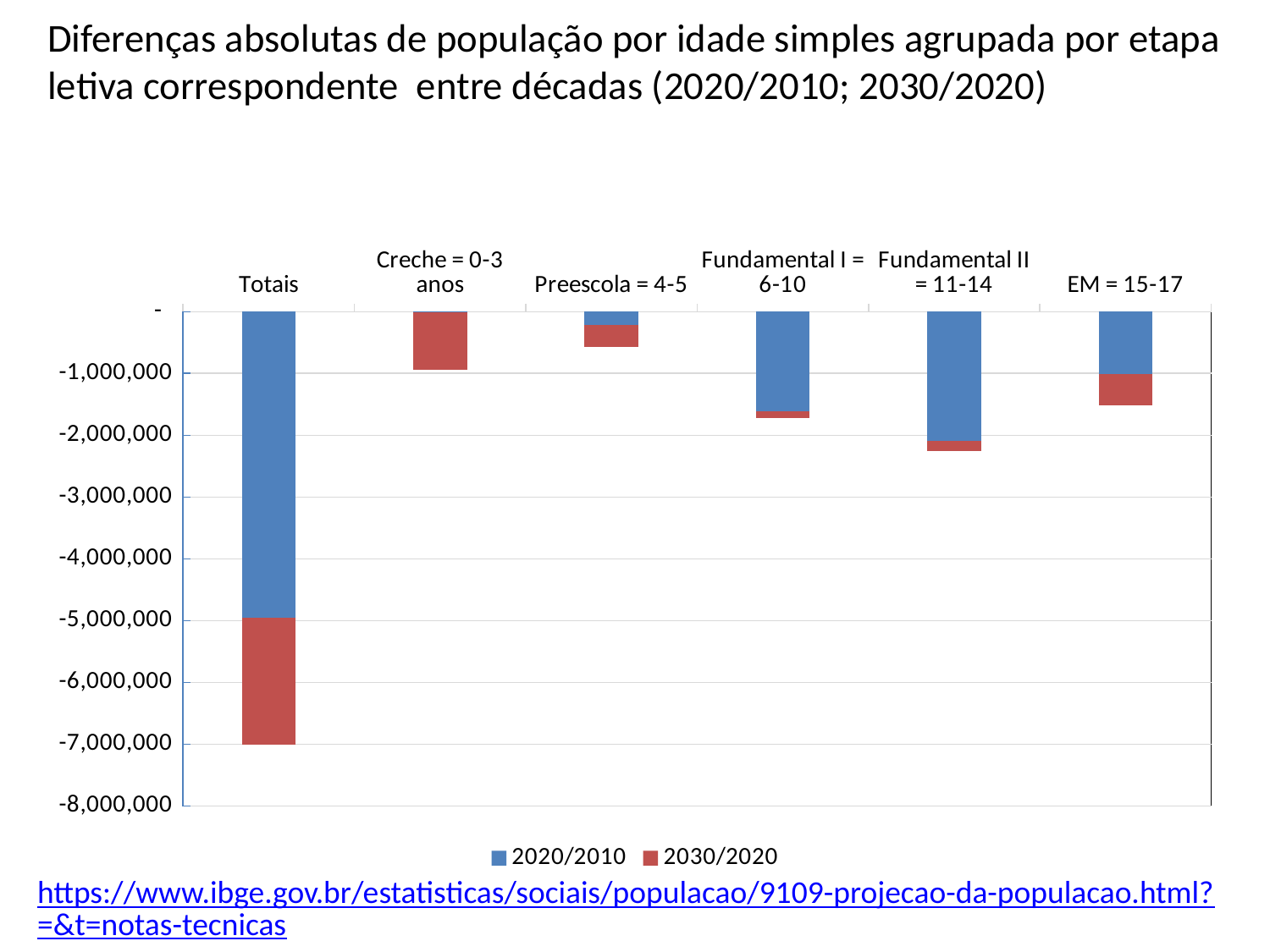
Is the total stacked value for Fundamental II = 11-14 greater or less than -2,000,000? less What kind of chart is shown on the slide? Stacked bar chart Is the total stacked value for Preescola = 4-5 greater or less than -1,000,000? greater Is the total stacked value for Totais greater or less than -6,000,000? less Which category has the shortest stacked bar (closest to zero)? Preescola = 4-5 Which has the larger (more negative) 2030/2020 segment: Creche = 0-3 anos or Preescola = 4-5? Creche = 0-3 anos Which has the larger (more negative) 2020/2010 segment: Fundamental I = 6-10 or Fundamental II = 11-14? Fundamental II = 11-14 Which category has the stacked bar extending furthest below zero? Totais How many categories are shown on the x axis? 6 Which series is shown in red in the legend? 2030/2020 How many series does the legend list? 2